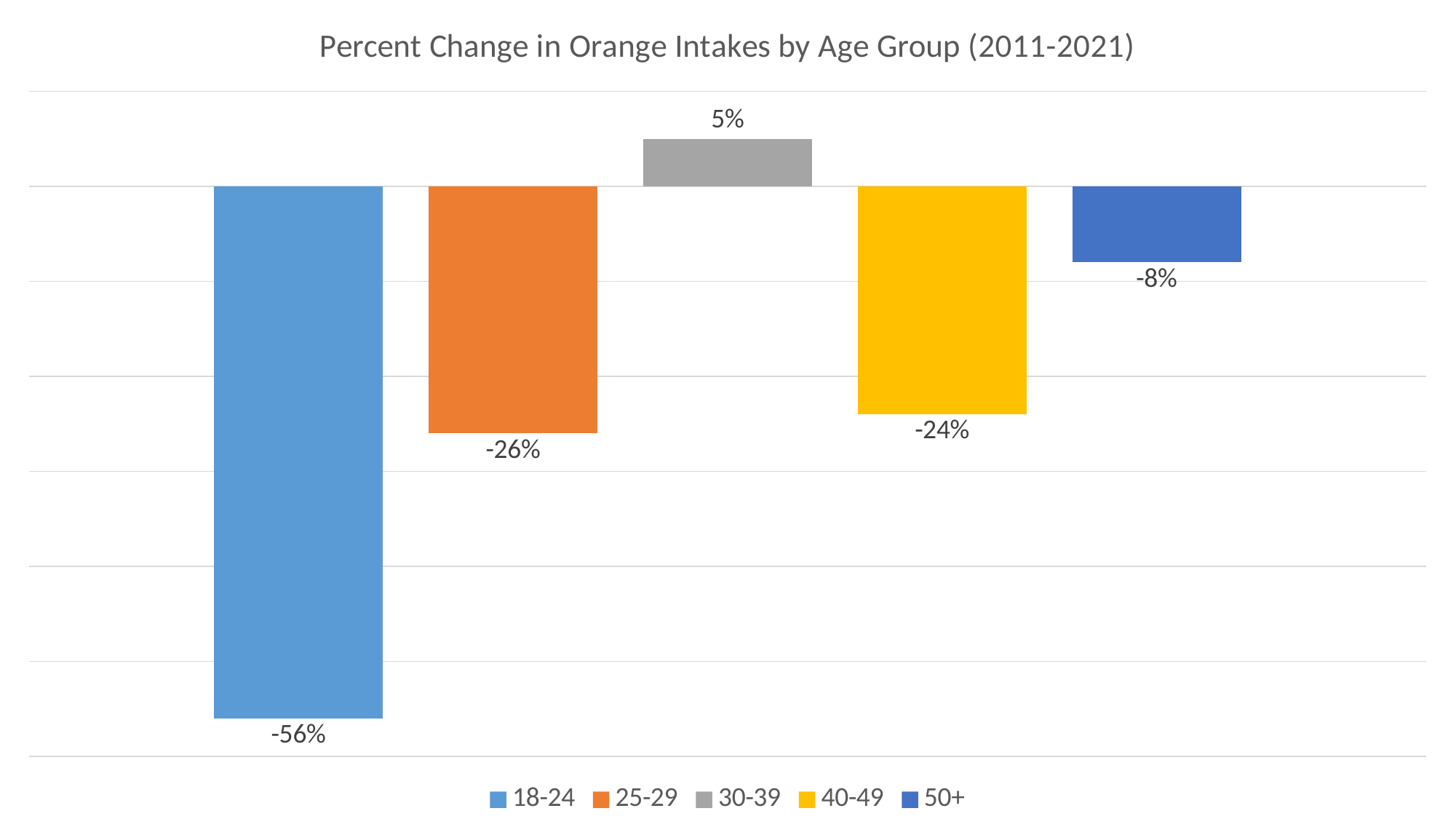
How many age groups are shown in the chart? 5 How many entries does the legend list? 5 Which age group has the highest percent change in orange intakes? 30-39 Which age group has the lowest percent change in orange intakes? 18-24 What is the difference between the percent change for the 18-24 group and the 25-29 group? 30 percentage points What is the percent change in orange intakes for the 30-39 age group? 5% What type of chart is shown on the slide? Bar chart What is the title of the chart? Percent Change in Orange Intakes by Age Group (2011-2021) What is the percent change in orange intakes for the 18-24 age group? -56% What is the percent change in orange intakes for the 40-49 age group? -24% What is the percent change in orange intakes for the 50+ age group? -8%